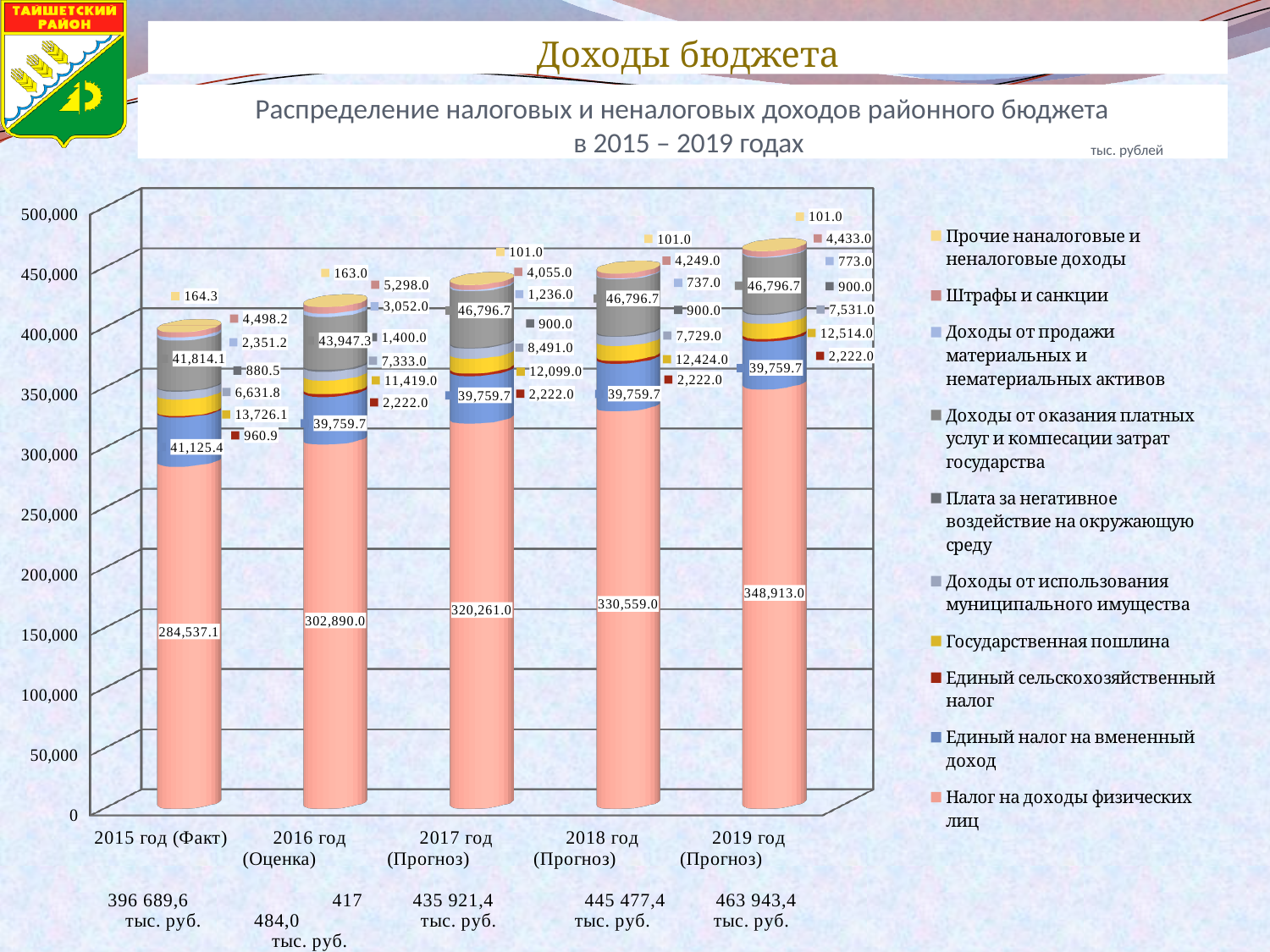
What is the total of the stacked bar for 2017 год (Прогноз), as printed on the slide? 435 921,4 тыс. руб. What is the difference between the Налог на доходы физических лиц values for 2019 год (Прогноз) and 2015 год (Факт)? 64,375.9 In which year is the value of Налог на доходы физических лиц the lowest? 2015 год (Факт) Which is larger: Штрафы и санкции in 2016 год (Оценка) or in 2017 год (Прогноз)? 2016 год (Оценка) In which year is the value of Налог на доходы физических лиц the highest? 2019 год (Прогноз) What is the value of Доходы от оказания платных услуг и компесации затрат государства for 2016 год (Оценка)? 43,947.3 What type of chart is shown on the slide? Stacked bar chart How many year categories are shown on the x axis of the chart? 5 Does the value of Налог на доходы физических лиц rise or fall from 2015 to 2019? Rises What is the value of Государственная пошлина for 2018 год (Прогноз)? 12,424.0 How many series does the chart legend list? 10 What is the value of Налог на доходы физических лиц for 2015 год (Факт)? 284,537.1